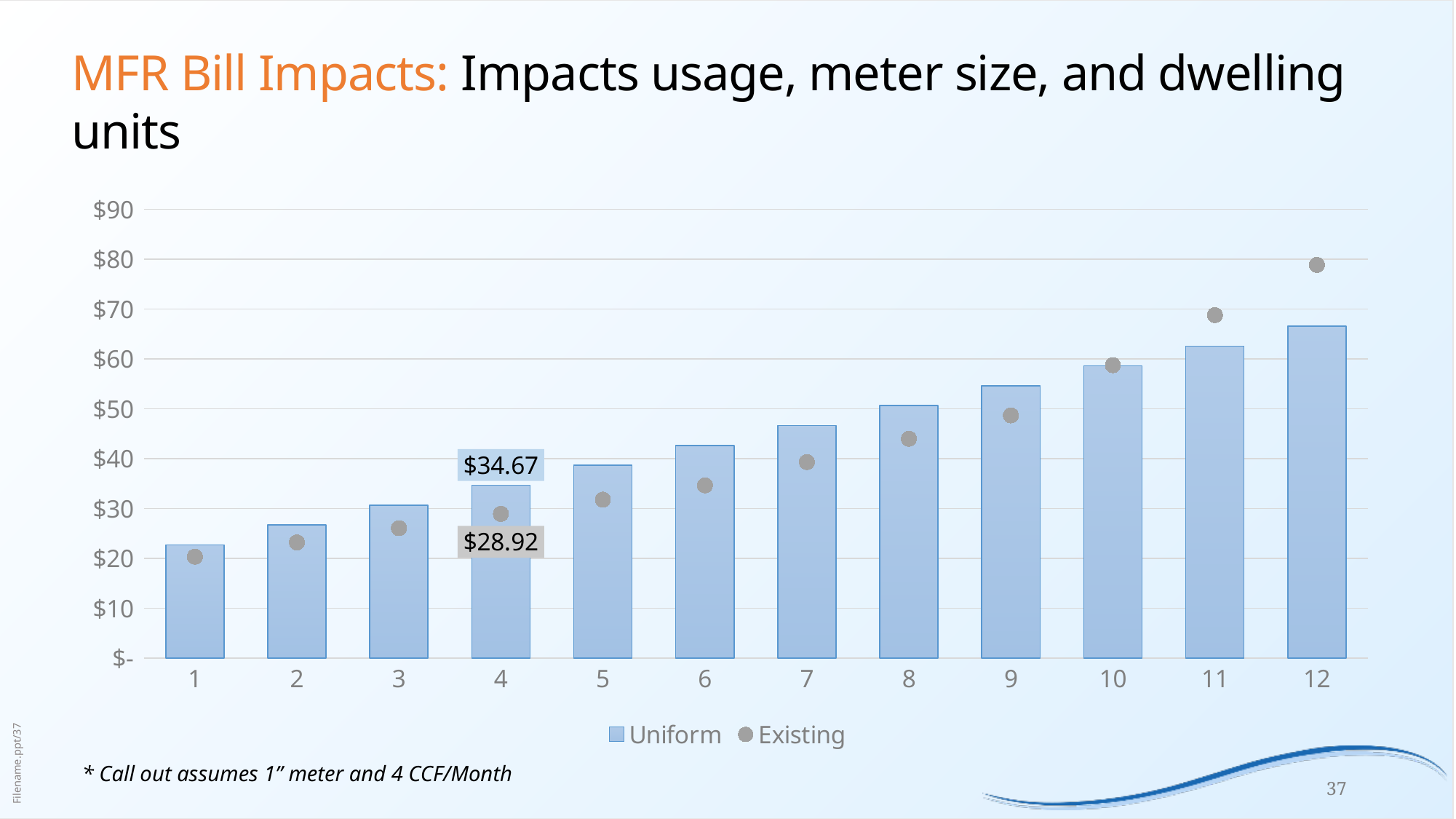
What is the Uniform value for category 4? $34.67 How many series does the legend list? 2 Which category has the highest Uniform bar? 12 Is the Existing value for category 12 greater or less than $70? greater For category 12, which is larger, the Uniform value or the Existing value? Existing What kind of chart is used to plot the Uniform series? bar chart What is the difference between the Uniform and Existing values for category 4? $5.75 Which category has the lowest Existing value? 1 How many categories are shown on the x axis? 12 What is the Existing value for category 4? $28.92 Do the Uniform values rise or fall as the categories go from 1 to 12? rise For category 4, which is larger, the Uniform value or the Existing value? Uniform